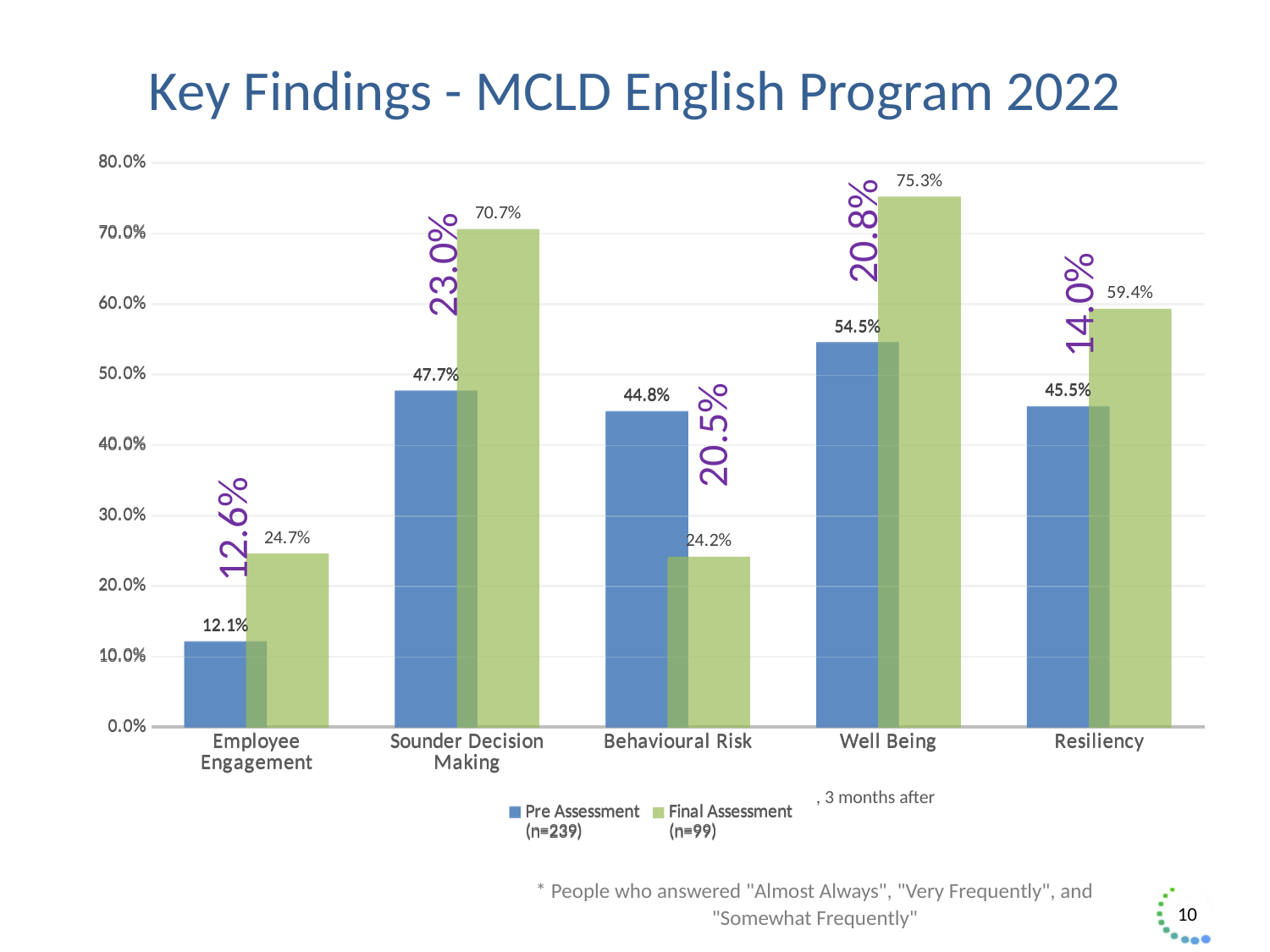
Which category has the lowest Pre Assessment value? Employee Engagement What kind of chart is shown on the slide? Bar chart What is the Final Assessment value for Behavioural Risk? 24.2% Which category has the highest Final Assessment value? Well Being How many categories are shown on the x axis? 5 For Behavioural Risk, which is larger: the Pre Assessment value or the Final Assessment value? Pre Assessment What is the Pre Assessment value for Employee Engagement? 12.1% What is the difference between the Final Assessment and Pre Assessment values for Sounder Decision Making? 23.0% What is the difference between the Final Assessment and Pre Assessment values for Well Being? 20.8% What is the Pre Assessment value for Resiliency? 45.5% How many series does the legend list? 2 What is the Final Assessment value for Sounder Decision Making? 70.7%